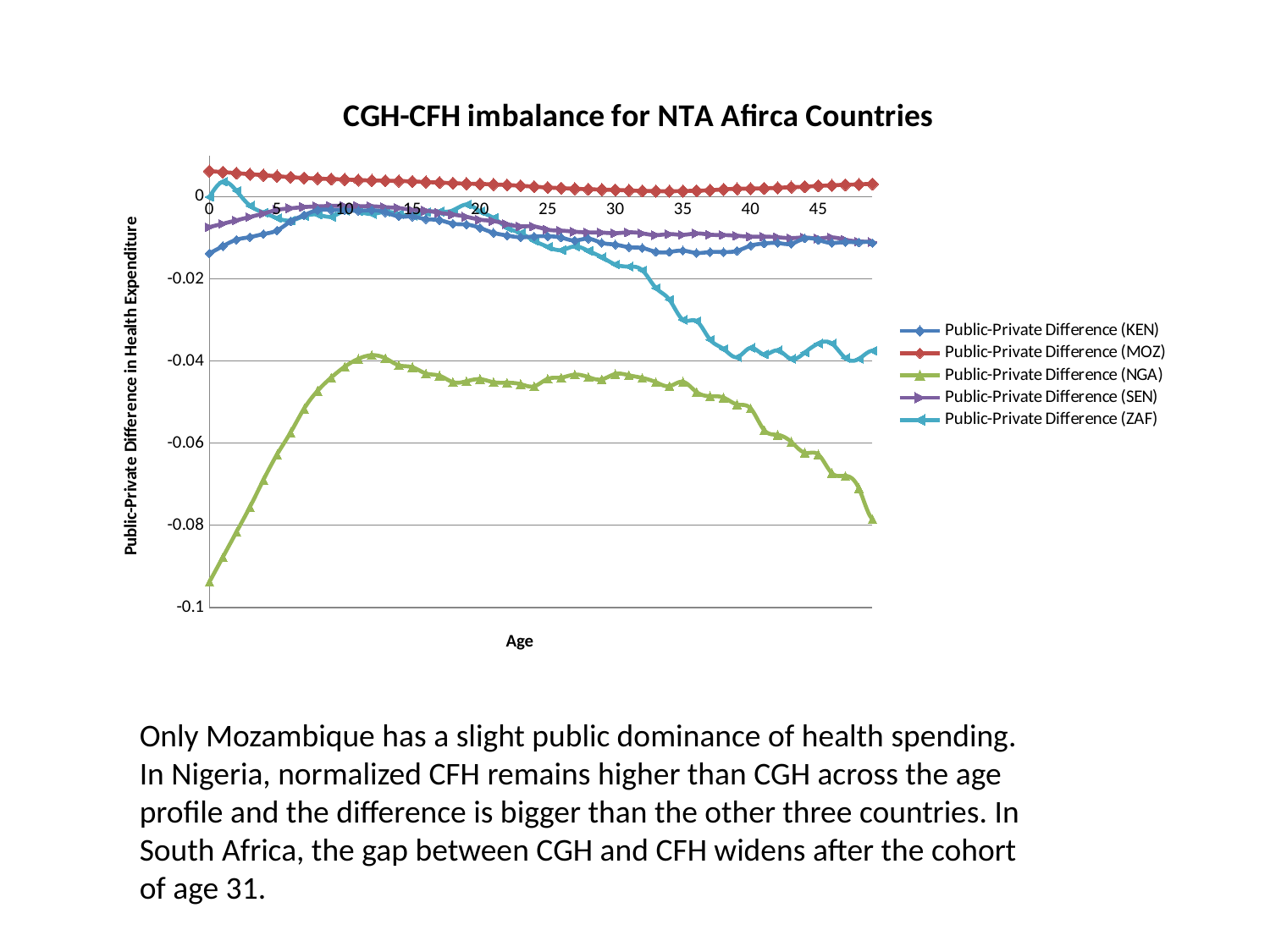
What kind of chart is shown on the slide? line chart What is the title of the chart? CGH-CFH imbalance for NTA Afirca Countries Which series has the highest values across the age profile? Public-Private Difference (MOZ) Does the Public-Private Difference (ZAF) series rise or fall between age 30 and age 40? fall Is the value for Public-Private Difference (ZAF) at age 45 greater or less than -0.02? less Does the Public-Private Difference (NGA) series rise or fall between age 0 and age 10? rise At age 40, which is larger: Public-Private Difference (KEN) or Public-Private Difference (ZAF)? Public-Private Difference (KEN) Is the value for Public-Private Difference (NGA) at age 0 greater or less than -0.08? less How many series does the legend list? 5 Is the value for Public-Private Difference (MOZ) at age 20 greater or less than 0? greater Which series has the lowest values across the age profile? Public-Private Difference (NGA) What is the label of the x axis? Age